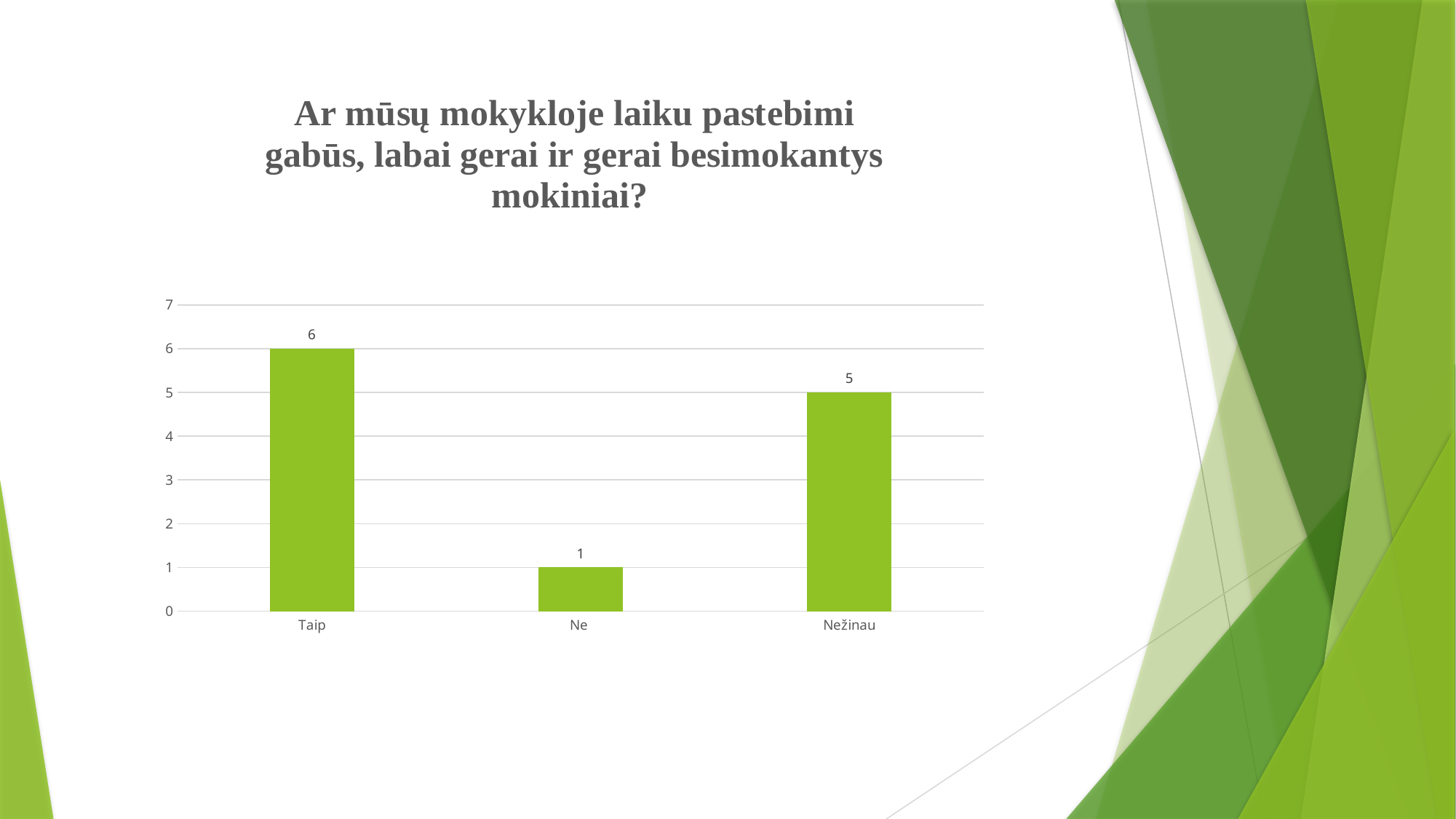
What is the difference between the values for Taip and Ne? 5 What is the title of the chart? Ar mūsų mokykloje laiku pastebimi gabūs, labai gerai ir gerai besimokantys mokiniai? What is the value for Ne? 1 How many categories are shown on the x axis? 3 What kind of chart is shown on the slide? bar chart What is the value for Nežinau? 5 Is the value for Nežinau greater or less than 3? greater What is the value for Taip? 6 Which is larger, the value for Ne or the value for Nežinau? Nežinau Which category has the lowest value? Ne Which category has the highest value? Taip What is the difference between the values for Taip and Nežinau? 1